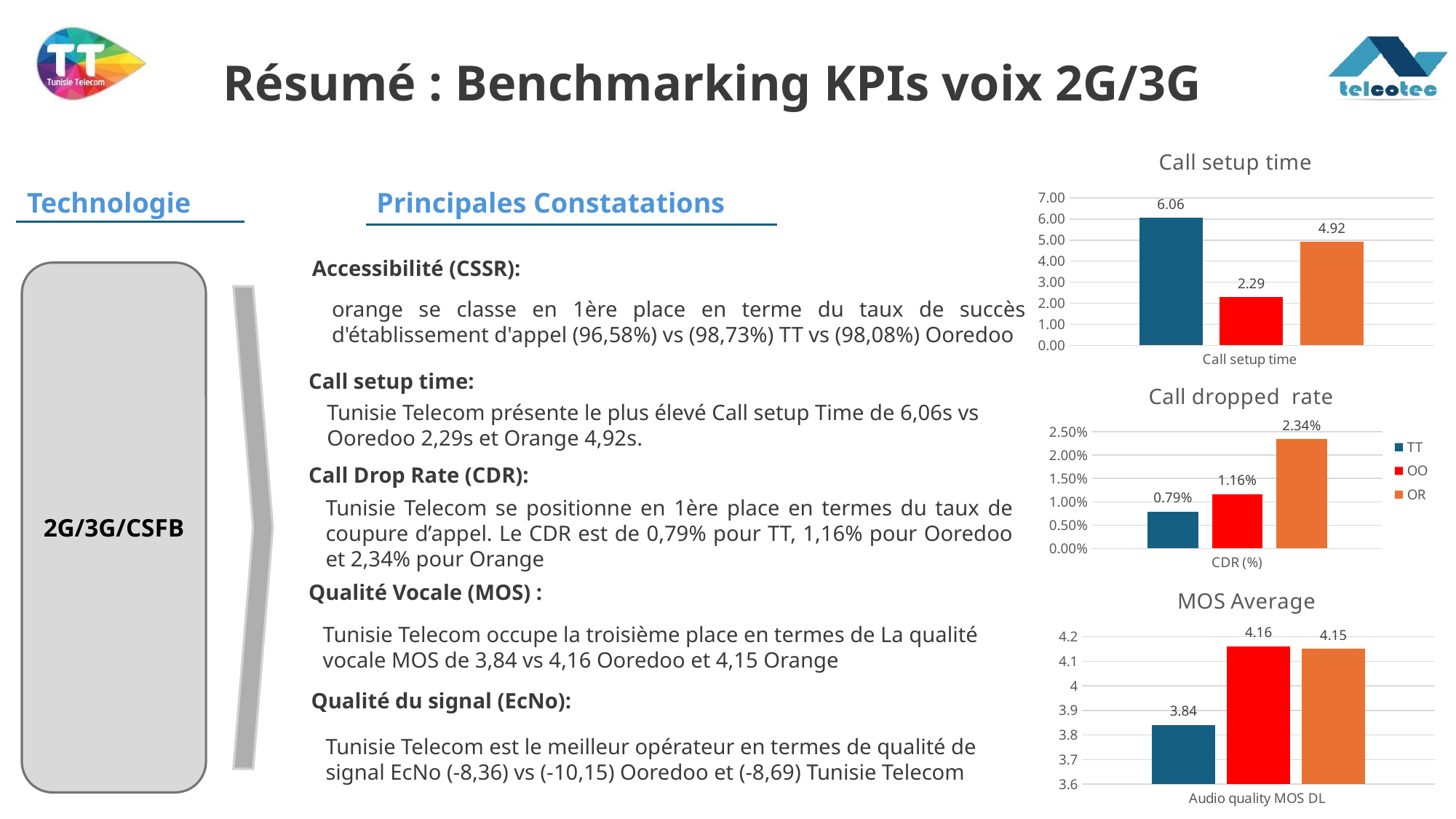
How many series does the legend of the 'Call dropped rate' chart list? 3 In the 'Call setup time' chart, what is the difference between the TT bar and the OR bar? 1.14 In the 'Call dropped rate' chart, what is the value for OR? 2.34% What is the x-axis category label shown under the bars in the 'MOS Average' chart? Audio quality MOS DL In the 'Call dropped rate' chart, is the value for OO greater or less than 1.00%? greater What type of chart is the 'MOS Average' chart? bar chart In the 'MOS Average' chart, which is larger, the red (OO) bar or the blue (TT) bar? OO (red) In the 'Call setup time' chart, what is the value of the red (OO) bar? 2.29 In the 'Call setup time' chart, what is the value of the blue (TT) bar? 6.06 In the 'Call dropped rate' chart, which series has the lowest value? TT In the 'MOS Average' chart, what is the value of the blue (TT) bar? 3.84 In the 'Call setup time' chart, which bar is the highest? TT (blue)